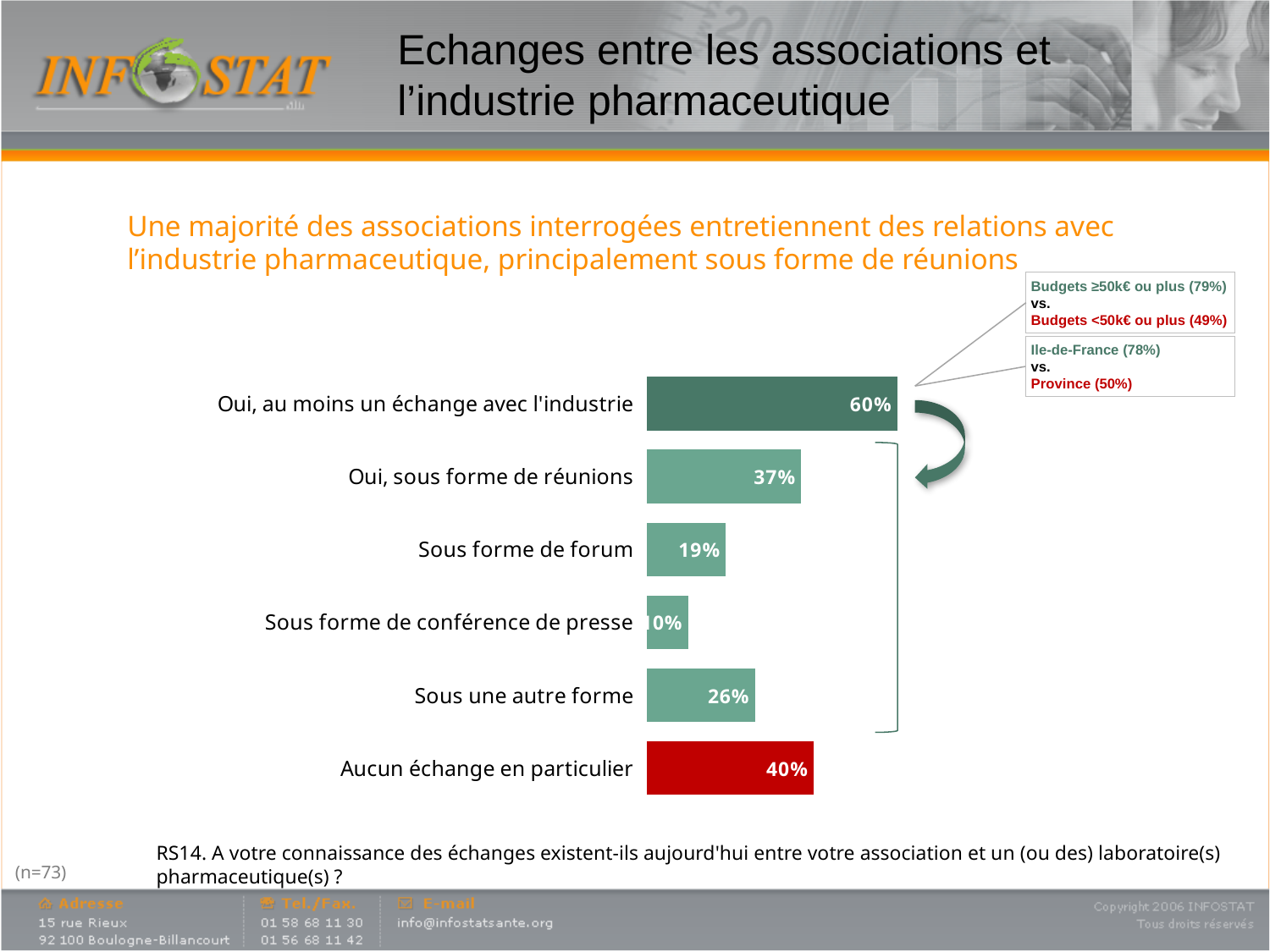
What is the value for "Oui, sous forme de réunions"? 37% What is the value for "Sous forme de conférence de presse"? 10% How many categories are shown in the chart? 6 What is the difference between "Oui, sous forme de réunions" and "Sous forme de forum"? 18% What is the value for "Oui, au moins un échange avec l'industrie"? 60% What kind of chart is shown on the slide? Bar chart Which bar is coloured red? Aucun échange en particulier What is the value for "Aucun échange en particulier"? 40% Which category has the lowest value? Sous forme de conférence de presse Which is larger: "Sous une autre forme" or "Sous forme de forum"? Sous une autre forme Which category has the highest value? Oui, au moins un échange avec l'industrie What is the value for "Sous forme de forum"? 19%